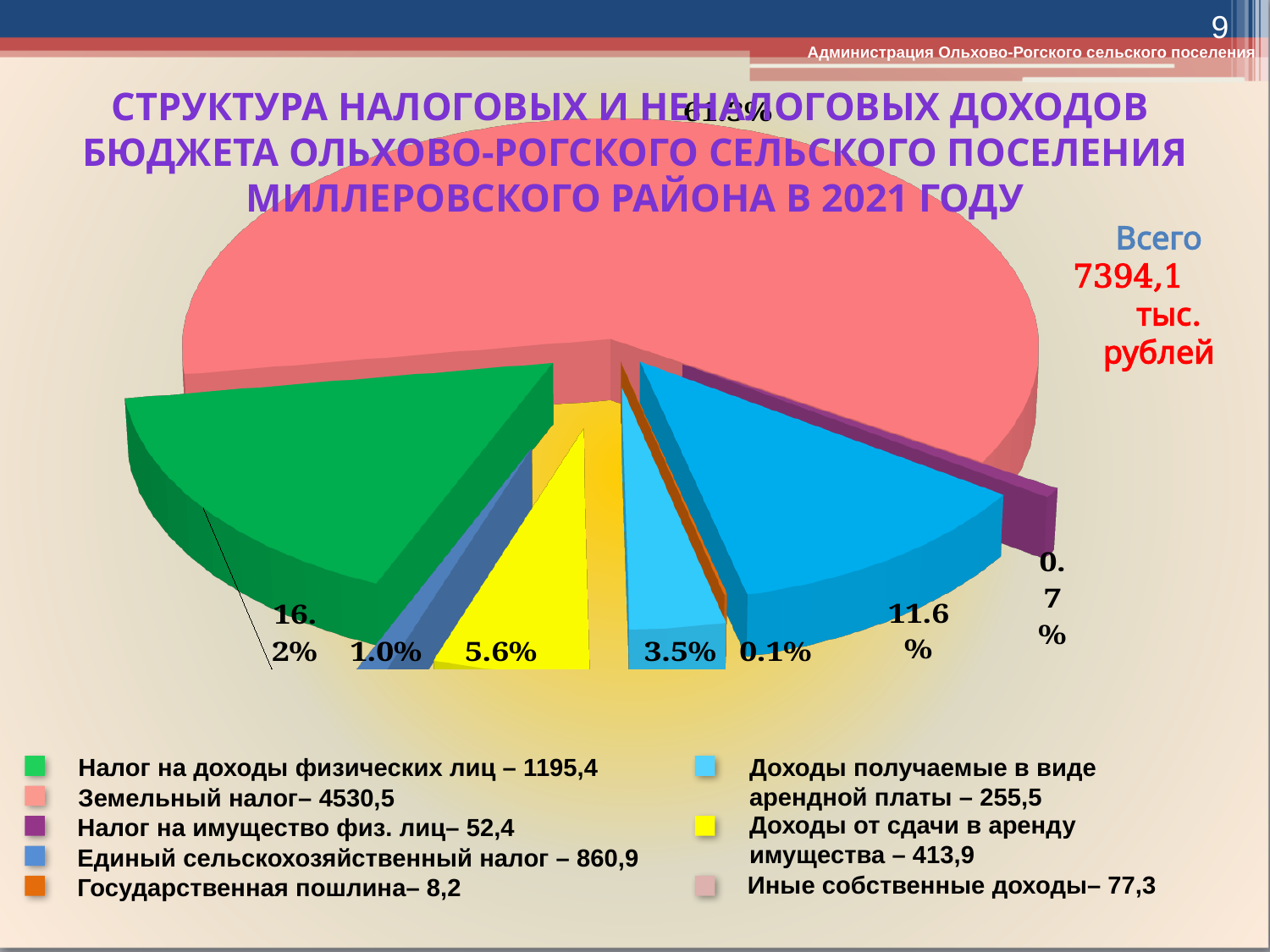
Which category has the smallest value? Государственная пошлина What is the value for Единый сельскохозяйственный налог? 860,9 What is the value for Налог на доходы физических лиц? 1195,4 Which category has the largest value? Земельный налог What total amount (Всего) is shown next to the chart? 7394,1 тыс. рублей What is the value for Государственная пошлина? 8,2 Which is larger: Налог на имущество физ. лиц or Иные собственные доходы? Иные собственные доходы What is the difference between Налог на доходы физических лиц (1195,4) and Единый сельскохозяйственный налог (860,9)? 334,5 What is the value for Земельный налог in the legend? 4530,5 What kind of chart is shown on the slide? pie chart What is the value for Доходы от сдачи в аренду имущества? 413,9 How many categories does the legend list? 8